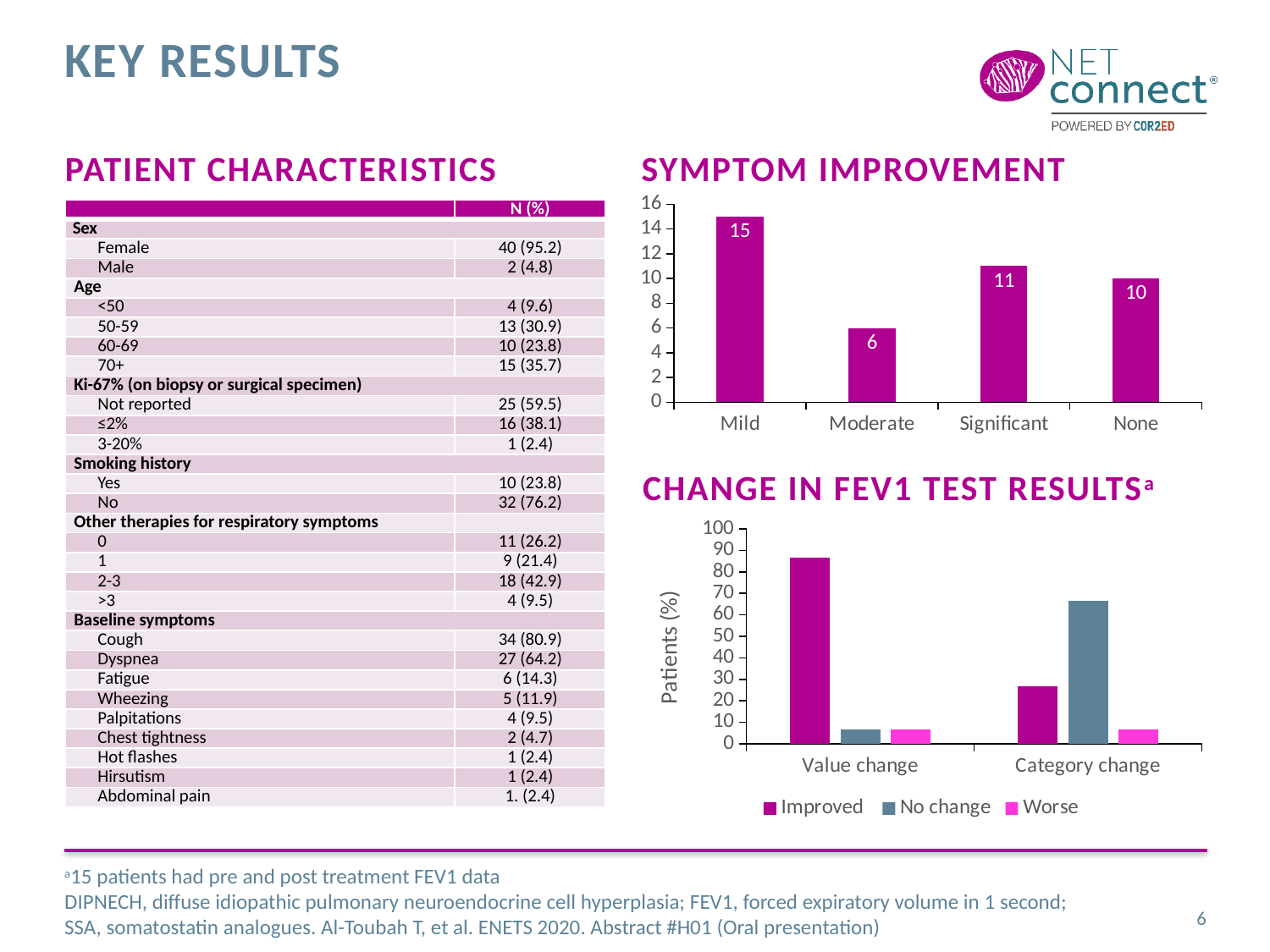
In the Symptom Improvement chart, what is the value for Moderate? 6 In the Symptom Improvement chart, which category has the highest value? Mild In the Change in FEV1 Test Results chart, which series has the larger value for Category change: Improved or No change? No change In the Symptom Improvement chart, what is the difference between the values for Mild and None? 5 In the Change in FEV1 Test Results chart, how many series does the legend list? 3 In the Symptom Improvement chart, which category has the lowest value? Moderate In the Change in FEV1 Test Results chart, is the Improved value for Value change greater or less than 80? greater What kind of chart is the Symptom Improvement chart? Bar chart In the Symptom Improvement chart, what is the value for Mild? 15 In the Symptom Improvement chart, how many categories are shown on the x axis? 4 In the Symptom Improvement chart, what is the value for Significant? 11 In the Change in FEV1 Test Results chart, what is the y-axis label? Patients (%)